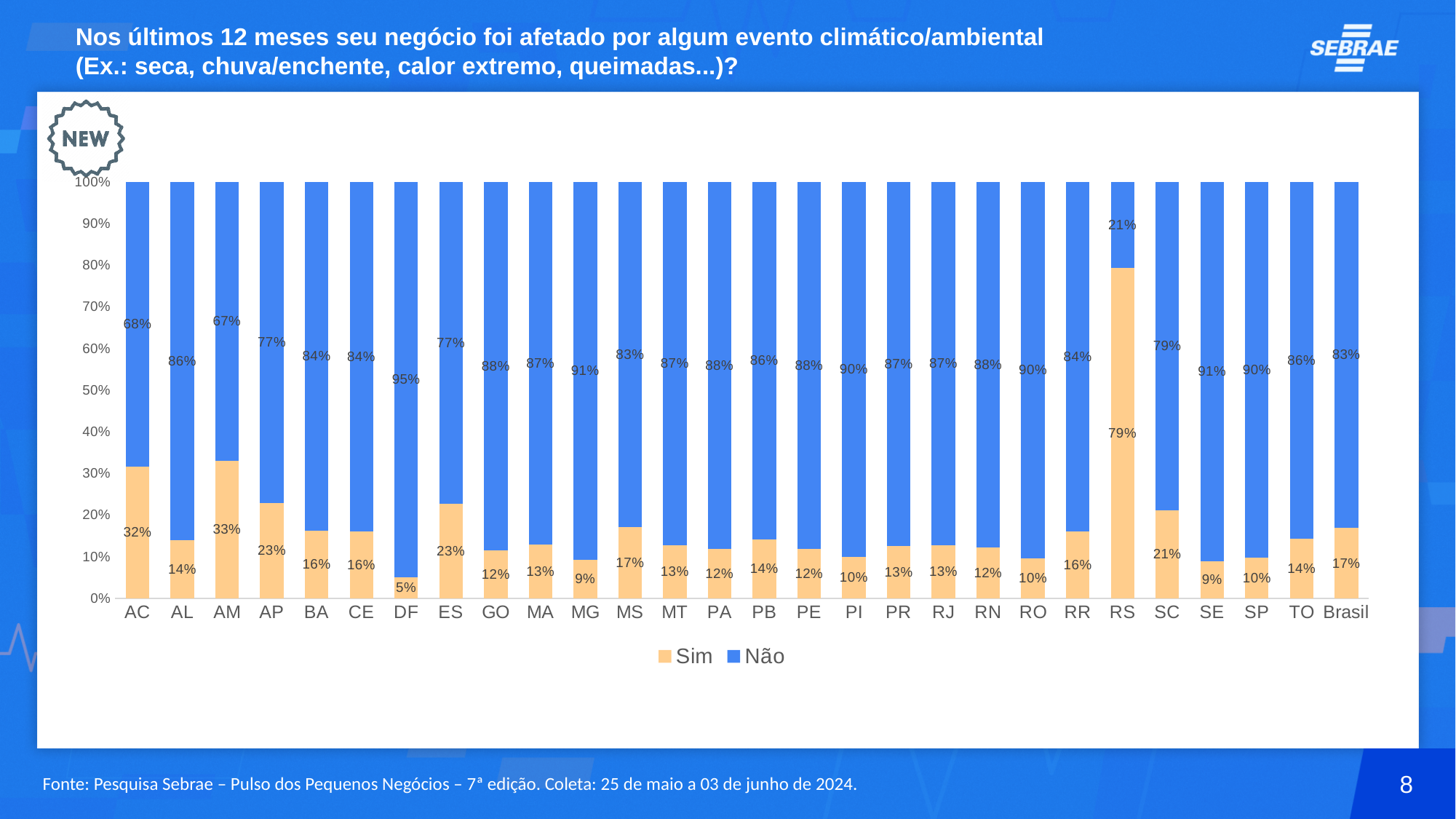
What are the two series named in the legend? Sim and Não Is the "Sim" value for RS greater or less than 70%? greater What is the "Não" value for DF? 95% Which category has the highest "Sim" share? RS Which category has the lowest "Sim" share? DF What is the "Sim" value for Brasil? 17% Which has a larger "Sim" share, AP or BA? AP What percentage of respondents in RS answered "Sim"? 79% What kind of chart is shown on the slide? Stacked bar chart How many categories are shown on the x axis? 28 How many series does the legend list? 2 What is the difference in percentage points between the "Sim" value for RS and the "Sim" value for Brasil? 62 percentage points